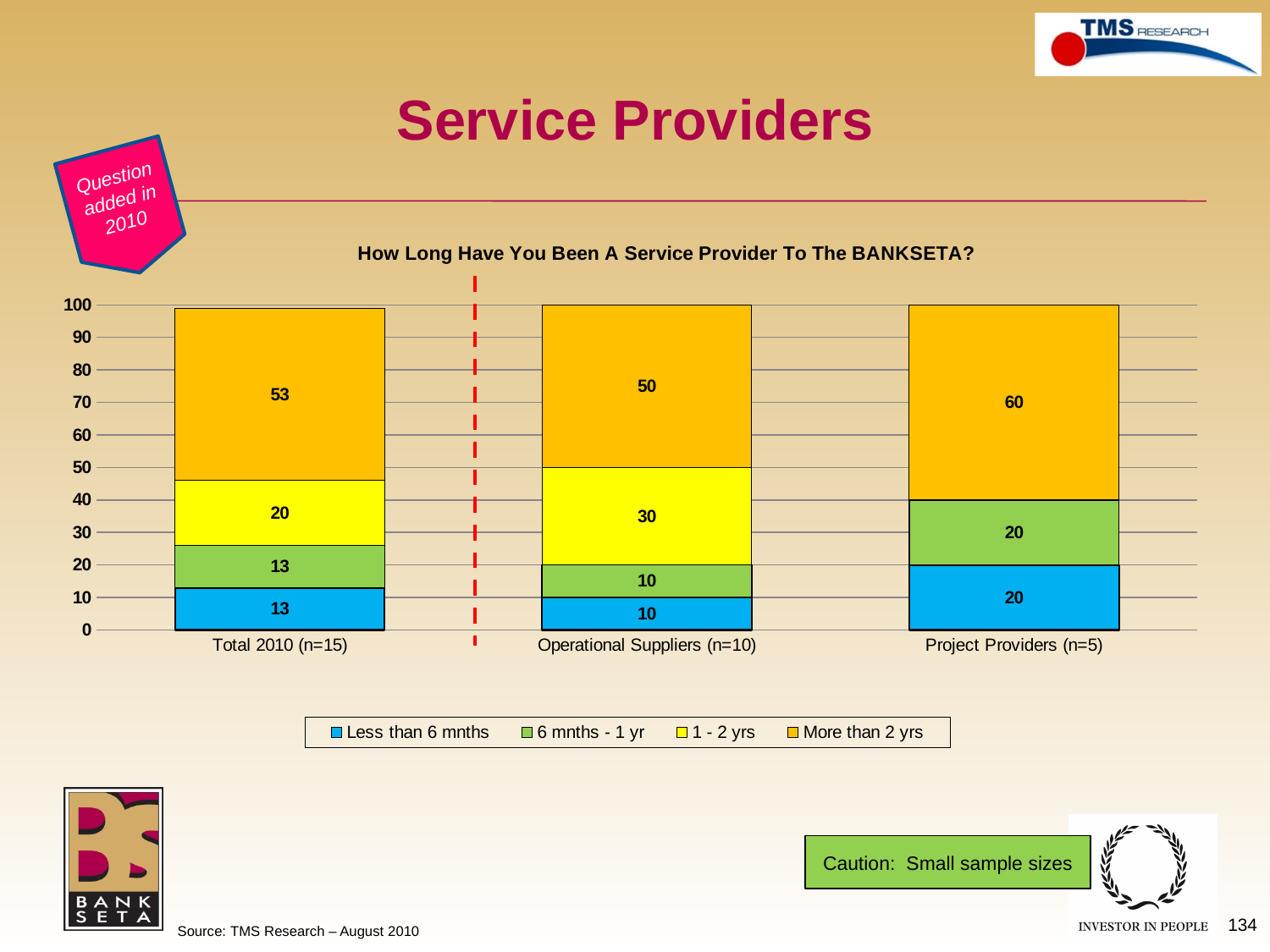
What is the value for 'Less than 6 mnths' in the Project Providers (n=5) bar? 20 What is the value for '1 - 2 yrs' in the Operational Suppliers (n=10) bar? 30 What is the value for '6 mnths - 1 yr' in the Total 2010 (n=15) bar? 13 What is the value for 'More than 2 yrs' in the Total 2010 (n=15) bar? 53 What is the title of the chart? How Long Have You Been A Service Provider To The BANKSETA? How many categories are shown on the x axis? 3 What is the difference between the 'More than 2 yrs' values for Project Providers (n=5) and Operational Suppliers (n=10)? 10 Which is larger: the '1 - 2 yrs' value for Total 2010 (n=15) or for Operational Suppliers (n=10)? Operational Suppliers (n=10) Which category has the highest value for 'More than 2 yrs'? Project Providers (n=5) What kind of chart is shown on the slide? Stacked bar chart How many series does the legend list? 4 Which category has the lowest value for 'Less than 6 mnths'? Operational Suppliers (n=10)